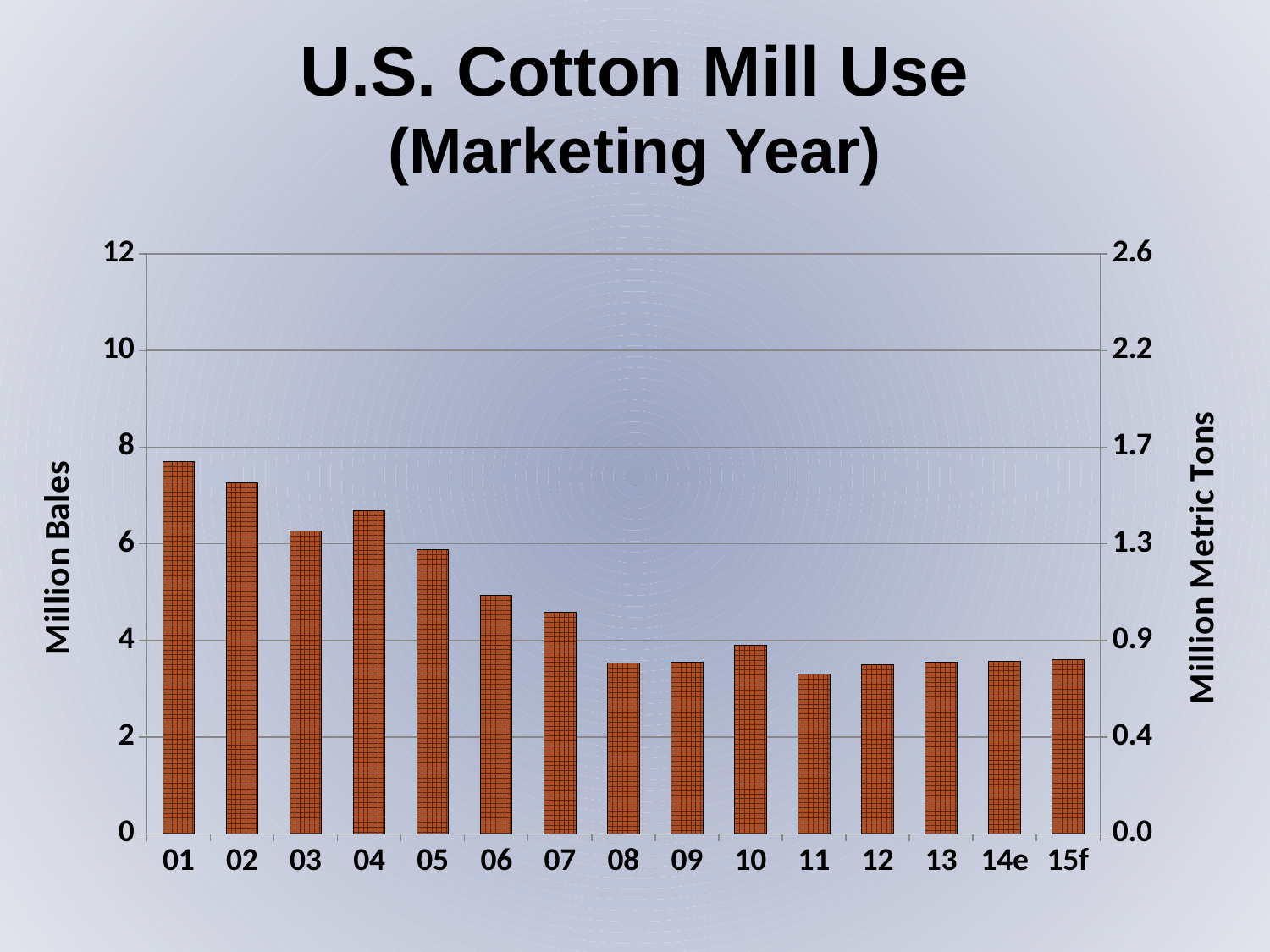
How many marketing years are plotted on the chart? 15 What is the label of the left vertical axis? Million Bales Is the value for 08 greater or less than 4 million bales? less Is the value for 07 greater or less than 4 million bales? greater Which is larger, the value for 10 or the value for 11? 10 Is the value for 05 greater or less than 6 million bales? less Which marketing year has the highest cotton mill use? 01 Which marketing year has the lowest cotton mill use? 11 Do the values generally rise or fall from 01 to 15f? fall What kind of chart is shown on the slide? bar chart Which is larger, the value for 02 or the value for 03? 02